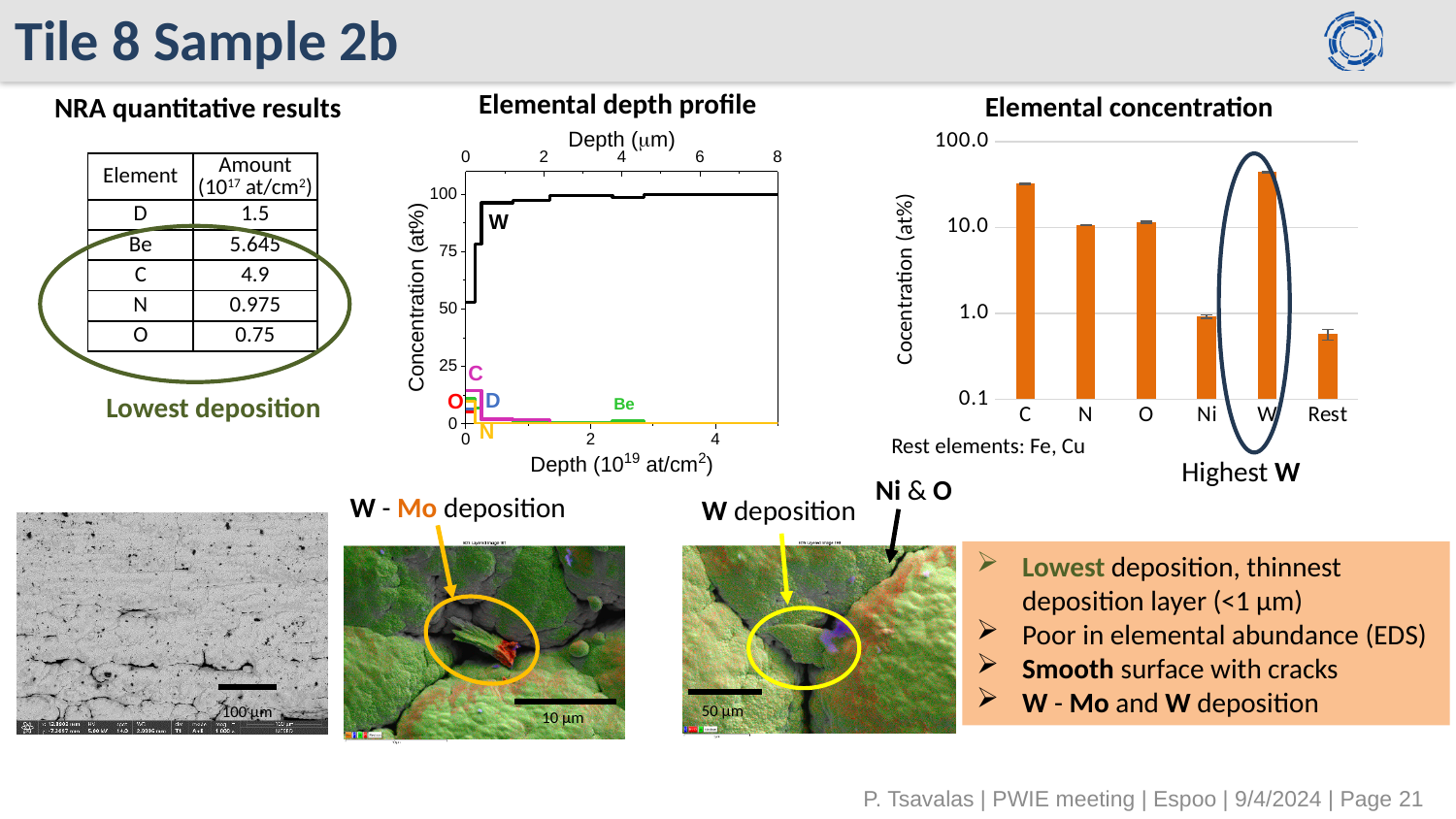
In the "Elemental depth profile" chart, which element has the highest concentration across the depth range? W What kind of chart is the "Elemental concentration" chart? bar chart In the "Elemental concentration" chart, which elements make up the "Rest" category? Fe, Cu In the "Elemental concentration" chart, is the value for W greater or less than 10.0? greater How many categories are shown on the x axis of the "Elemental concentration" chart? 6 In the "Elemental concentration" chart, which element has the highest concentration? W In the "Elemental concentration" chart, is the value for C greater or less than 10.0? greater In the "Elemental concentration" chart, which category has the lowest concentration? Rest What kind of chart is the "Elemental depth profile" chart? line chart In the "Elemental depth profile" chart, does the W concentration rise or fall as depth increases? rise In the "Elemental concentration" chart, which is larger, the value for C or the value for Ni? C